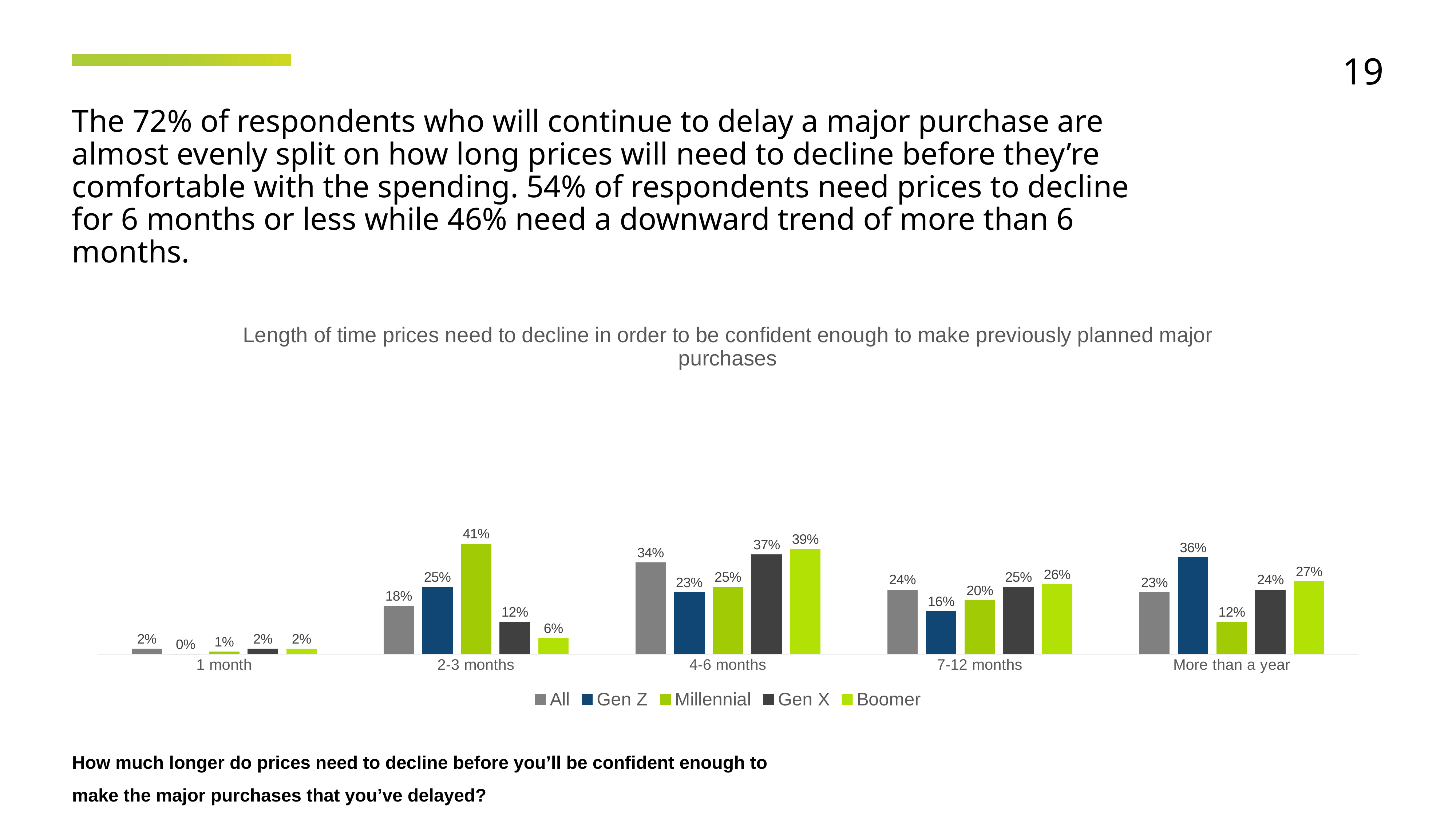
What is the value for Gen Z in the More than a year category? 36% What is the value for Millennial in the 2-3 months category? 41% Which is larger in the More than a year category: Gen Z or Millennial? Gen Z What is the value for Boomer in the 7-12 months category? 26% How many series does the legend list? 5 What is the value for All in the 4-6 months category? 34% Which category has the highest value for the All series? 4-6 months What is the difference between the Millennial and Boomer values in the 2-3 months category? 35% Which category has the lowest value for the Gen Z series? 1 month What kind of chart is shown on the slide? Bar chart What is the title of the chart? Length of time prices need to decline in order to be confident enough to make previously planned major purchases How many time-period categories are shown on the x axis? 5